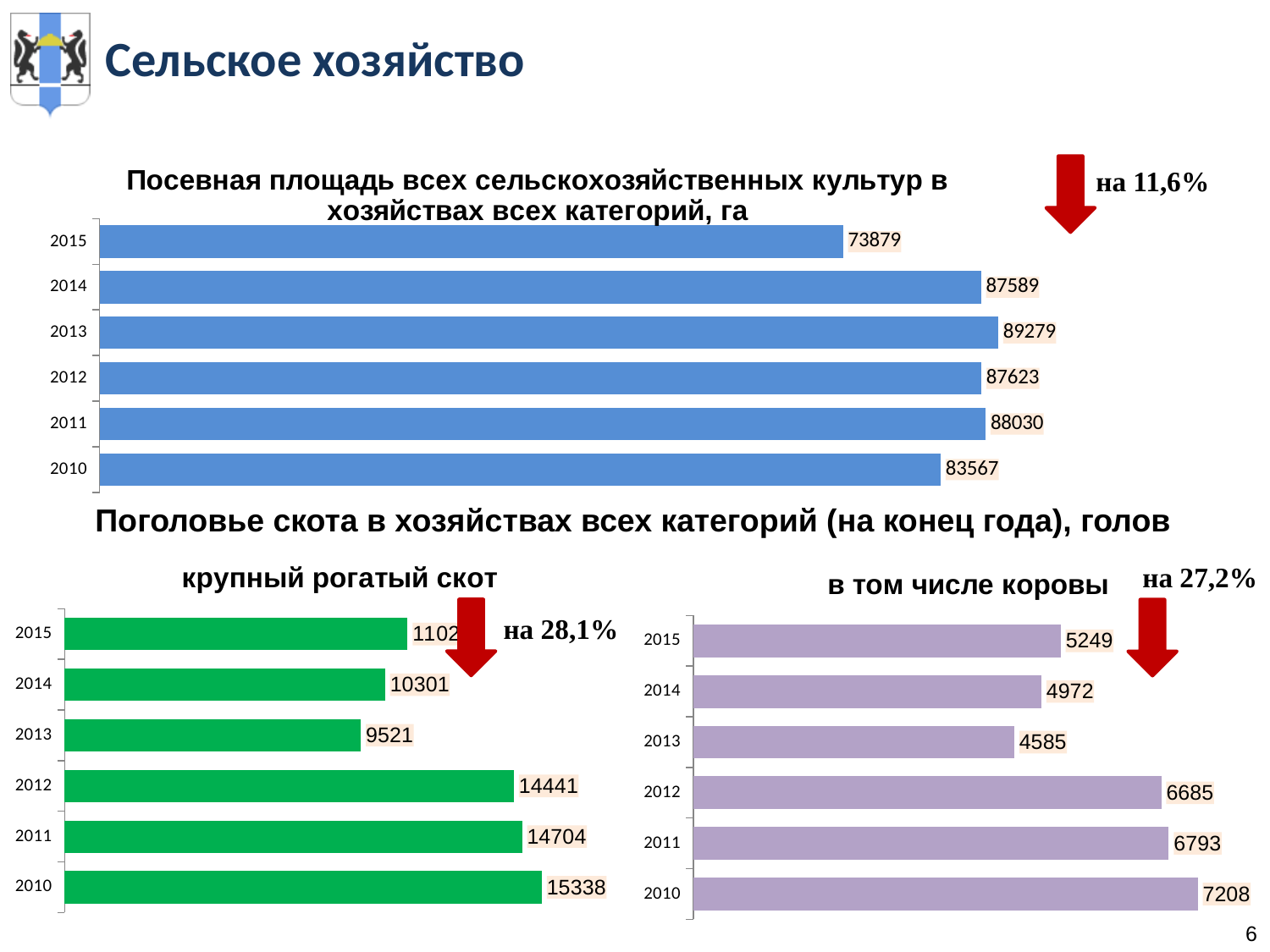
In the chart 'крупный рогатый скот', what is the difference between the values for 2012 and 2013? 4920 What type of chart is 'в том числе коровы'? bar chart In the chart 'в том числе коровы', what is the value for 2011? 6793 In the chart 'в том числе коровы', which year has the highest value? 2010 In the chart 'крупный рогатый скот', which year has the lowest value? 2013 In the chart 'Посевная площадь всех сельскохозяйственных культур в хозяйствах всех категорий, га', what is the value for 2015? 73879 In the chart 'Посевная площадь всех сельскохозяйственных культур в хозяйствах всех категорий, га', which year has the highest value? 2013 In the chart 'Посевная площадь всех сельскохозяйственных культур в хозяйствах всех категорий, га', which year has the lowest value? 2015 In the chart 'Посевная площадь всех сельскохозяйственных культур в хозяйствах всех категорий, га', how many years are shown? 6 In the chart 'Посевная площадь всех сельскохозяйственных культур в хозяйствах всех категорий, га', what is the difference between the values for 2014 and 2015? 13710 In the chart 'крупный рогатый скот', what is the value for 2010? 15338 In the chart 'в том числе коровы', which is larger, the value for 2014 or the value for 2015? 2015